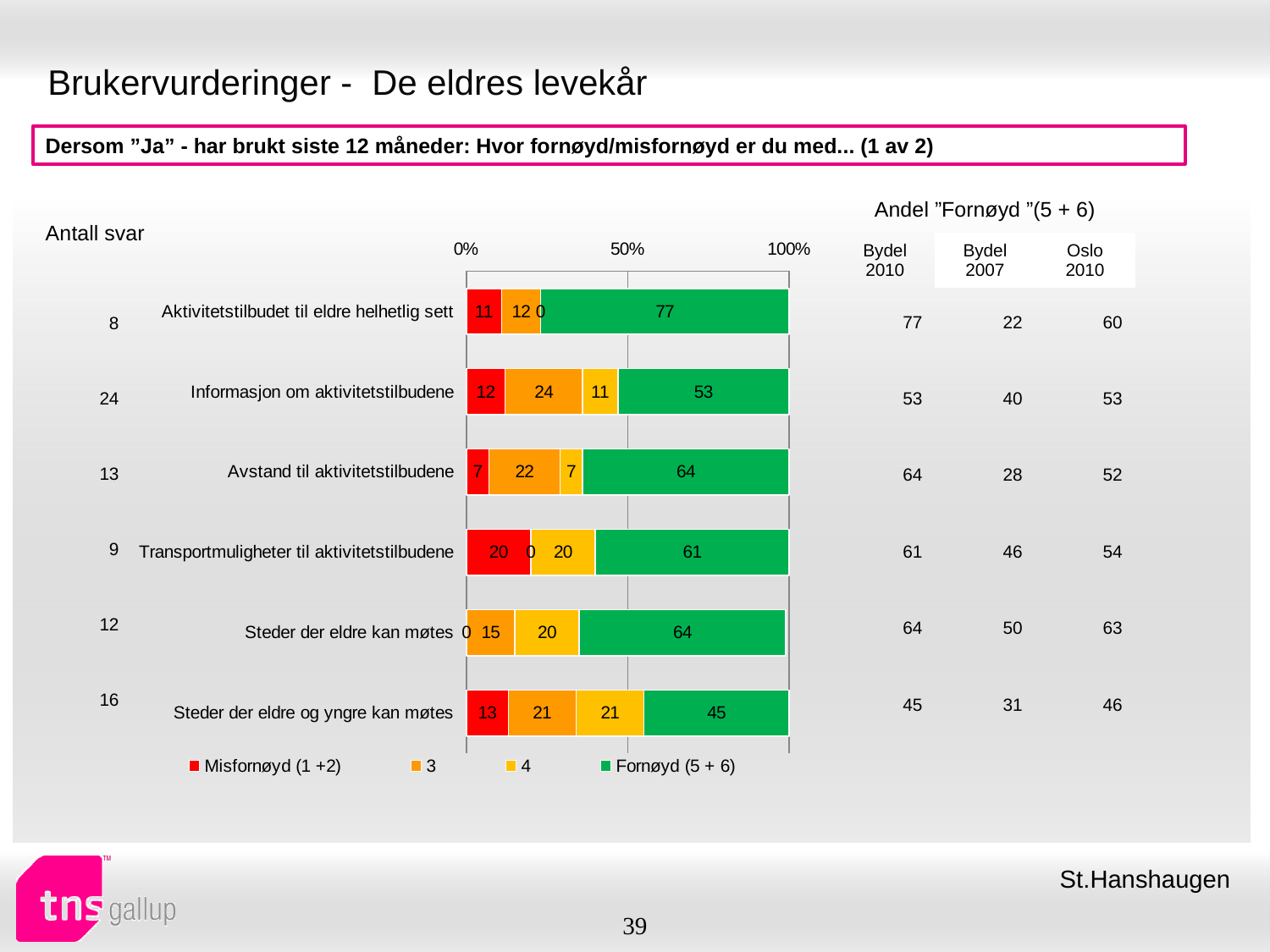
What is the total of the stacked bar for Aktivitetstilbudet til eldre helhetlig sett? 100 How many categories are shown in the bar chart? 6 What is the value of series 3 for Informasjon om aktivitetstilbudene? 24 How many series does the legend list? 4 What is the Fornøyd (5 + 6) value for Aktivitetstilbudet til eldre helhetlig sett? 77 What is the difference between the Fornøyd (5 + 6) values for Aktivitetstilbudet til eldre helhetlig sett and Informasjon om aktivitetstilbudene? 24 What is the Misfornøyd (1 +2) value for Transportmuligheter til aktivitetstilbudene? 20 Which has a larger Misfornøyd (1 +2) value: Avstand til aktivitetstilbudene or Steder der eldre og yngre kan møtes? Steder der eldre og yngre kan møtes What kind of chart is shown on the slide? Stacked bar chart Which category has the highest Fornøyd (5 + 6) value? Aktivitetstilbudet til eldre helhetlig sett Which category has the lowest Fornøyd (5 + 6) value? Steder der eldre og yngre kan møtes Which legend entry is shown in green? Fornøyd (5 + 6)